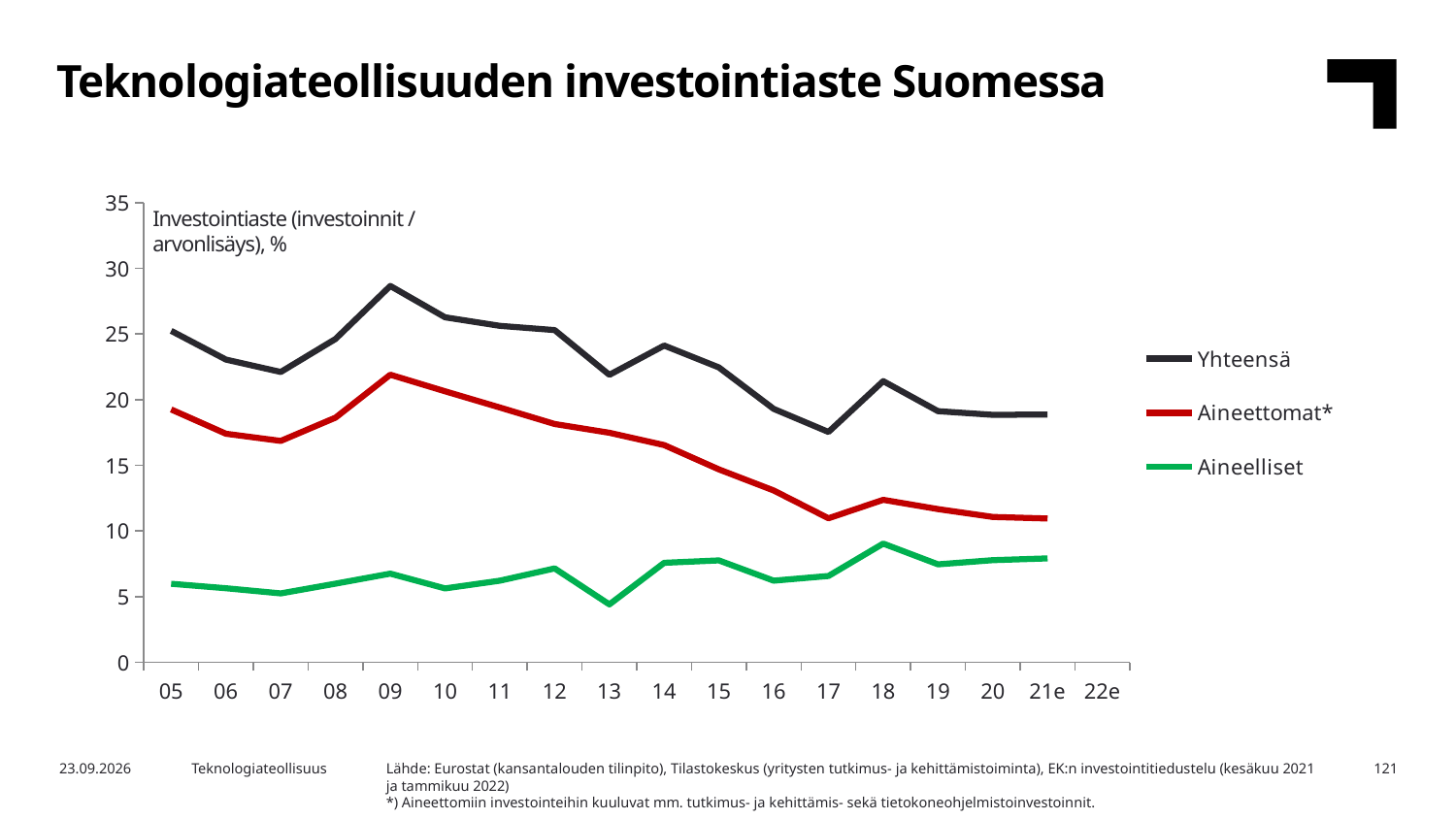
In which year does the Yhteensä series reach its highest value? 09 Is the value for Yhteensä in 17 greater or less than 20? less What kind of chart is shown on the slide? line chart In which year does the Yhteensä series reach its lowest value? 17 Which series has the larger value in 20, Aineettomat* or Aineelliset? Aineettomat* In which year does the Aineelliset series reach its lowest value? 13 Is the value for Yhteensä in 09 greater or less than 25? greater Does the Aineettomat* series rise or fall from 09 to 17? fall In which year does the Aineettomat* series reach its highest value? 09 Is the value for Aineelliset in 18 greater or less than 5? greater How many series does the legend list? 3